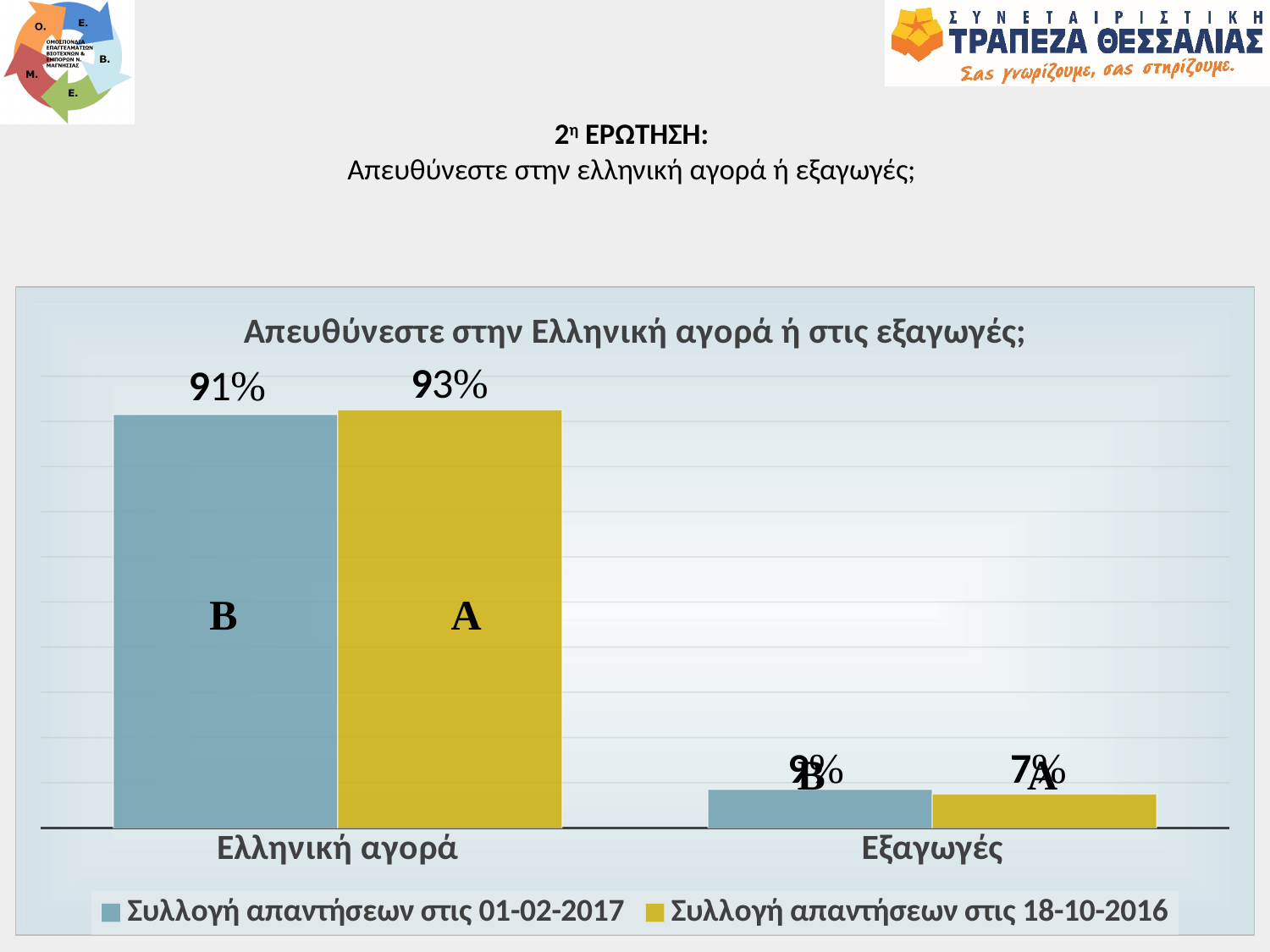
What is the value for Ελληνική αγορά in the series Συλλογή απαντήσεων στις 01-02-2017? 91% What is the title of the chart? Απευθύνεστε στην Ελληνική αγορά ή στις εξαγωγές; How many categories are shown on the x axis of the chart? 2 Which category has the highest value in the series Συλλογή απαντήσεων στις 18-10-2016? Ελληνική αγορά What type of chart is shown on the slide? bar chart What is the value for Εξαγωγές in the series Συλλογή απαντήσεων στις 18-10-2016? 7% For Εξαγωγές, which series has the larger value: Συλλογή απαντήσεων στις 01-02-2017 or Συλλογή απαντήσεων στις 18-10-2016? Συλλογή απαντήσεων στις 01-02-2017 Which category has the lowest value in the series Συλλογή απαντήσεων στις 01-02-2017? Εξαγωγές What is the difference between the Ελληνική αγορά values of the two series? 2% What is the value for Ελληνική αγορά in the series Συλλογή απαντήσεων στις 18-10-2016? 93% How many series does the chart legend list? 2 What is the value for Εξαγωγές in the series Συλλογή απαντήσεων στις 01-02-2017? 9%